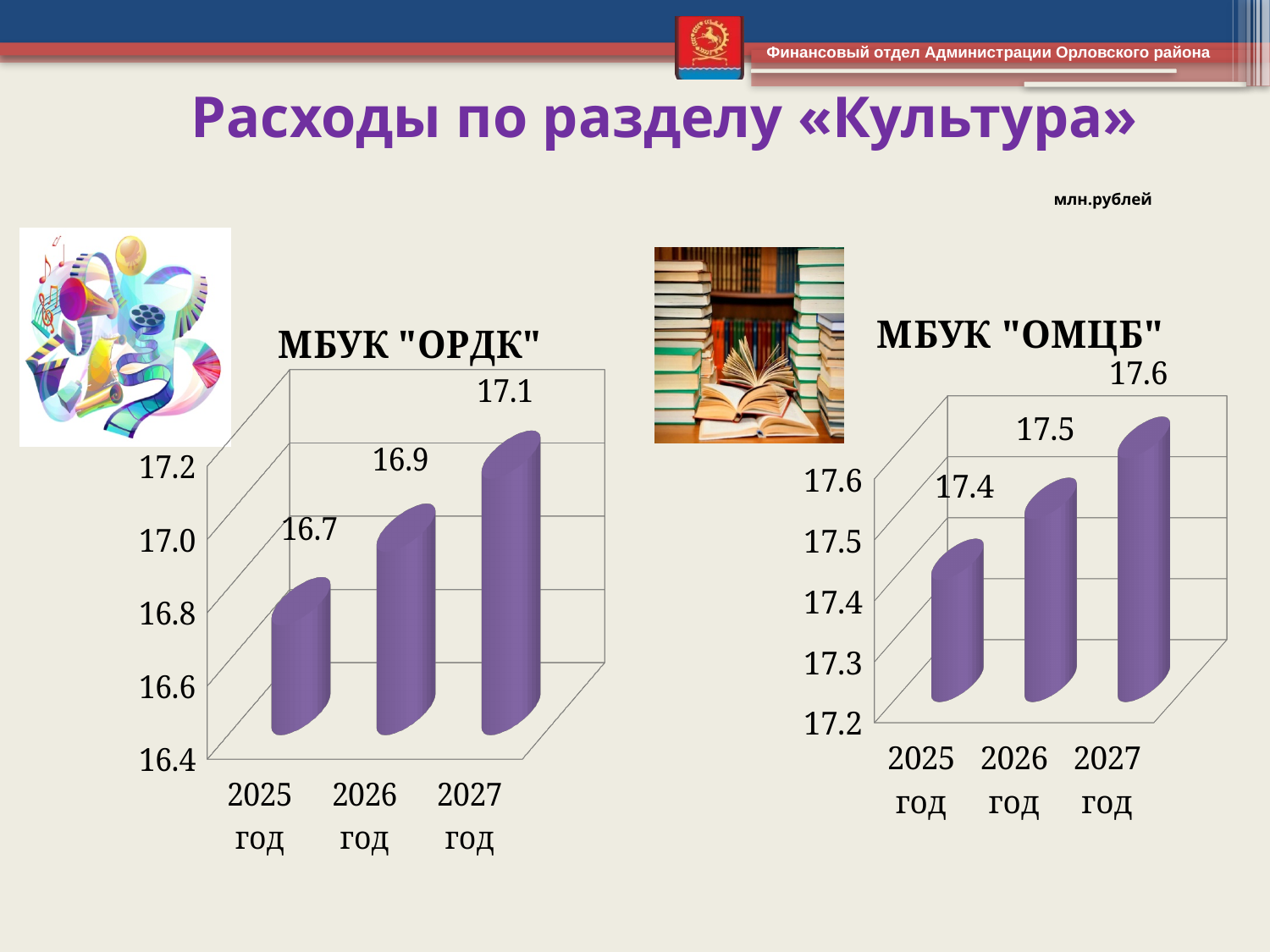
In the МБУК "ОМЦБ" chart, what is the value for 2026 год? 17.5 In the МБУК "ОРДК" chart, what is the value for 2027 год? 17.1 In the МБУК "ОМЦБ" chart, what is the difference between the values for 2027 год and 2026 год? 0.1 What kind of chart is the МБУК "ОРДК" chart? bar chart In the МБУК "ОРДК" chart, what is the value for 2025 год? 16.7 In the МБУК "ОМЦБ" chart, which year has the lowest value? 2025 год How many years are shown in the МБУК "ОМЦБ" chart? 3 In the МБУК "ОМЦБ" chart, what is the value for 2025 год? 17.4 In the МБУК "ОРДК" chart, which year has the highest value? 2027 год Which is larger: the 2026 год value in the МБУК "ОРДК" chart or the 2026 год value in the МБУК "ОМЦБ" chart? МБУК "ОМЦБ" In the МБУК "ОРДК" chart, do the values rise or fall from 2025 год to 2027 год? rise In the МБУК "ОРДК" chart, what is the difference between the values for 2027 год and 2025 год? 0.4